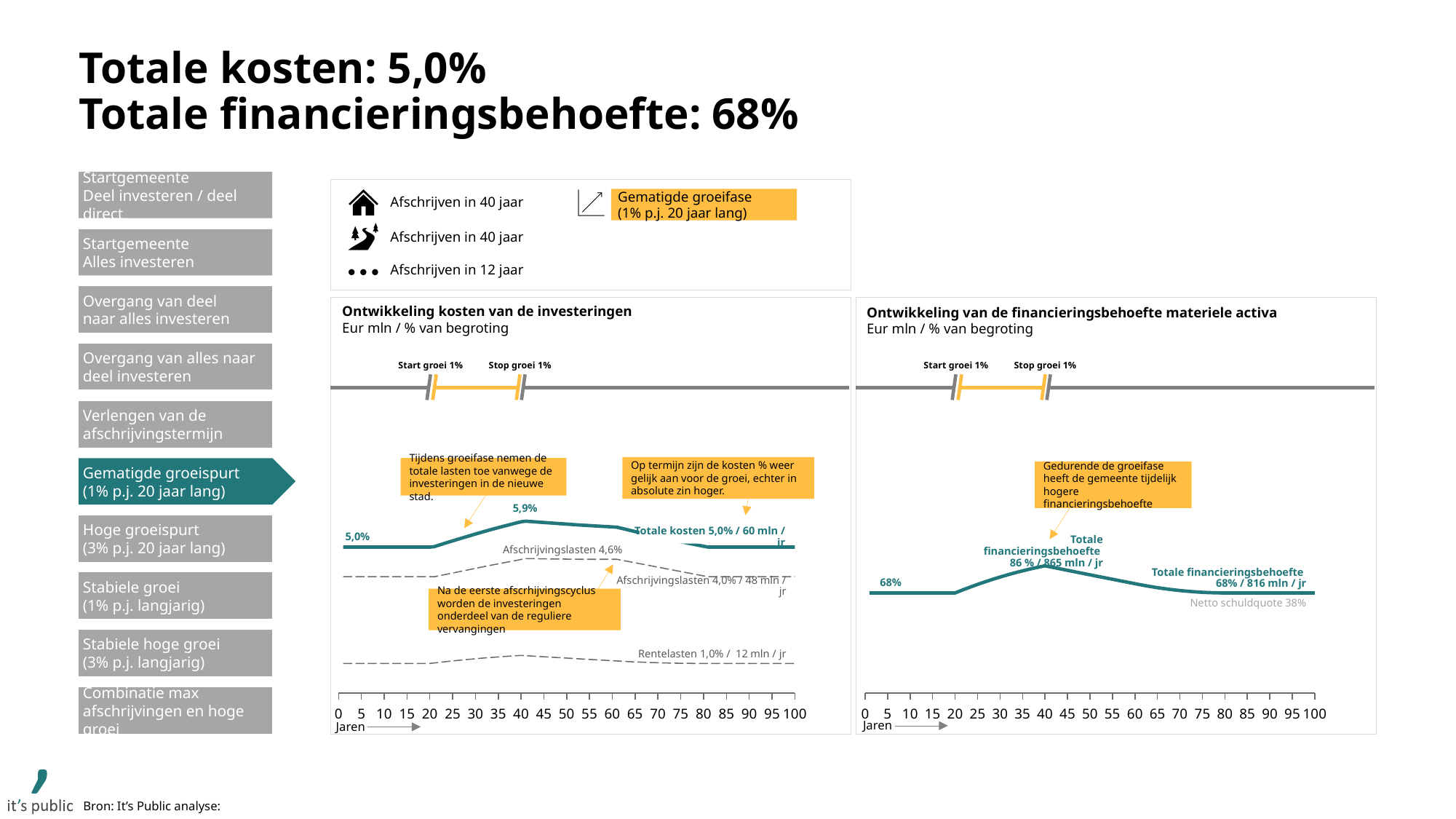
In the chart 'Ontwikkeling kosten van de investeringen', what is the peak value labelled for Afschrijvingslasten? 4,6% In the chart 'Ontwikkeling van de financieringsbehoefte materiele activa', what is the starting value of the Totale financieringsbehoefte line? 68% In the chart 'Ontwikkeling van de financieringsbehoefte materiele activa', what is the difference in percentage points between the peak financieringsbehoefte (86%) and the end value (68%)? 18 In the chart 'Ontwikkeling kosten van de investeringen', which is larger at the end of the period: Afschrijvingslasten or Rentelasten? Afschrijvingslasten What is the last value shown on the x axis (Jaren) of the chart 'Ontwikkeling van de financieringsbehoefte materiele activa'? 100 In the chart 'Ontwikkeling kosten van de investeringen', what is the starting value of the Totale kosten line? 5,0% What kind of chart is 'Ontwikkeling kosten van de investeringen'? Line chart In the chart 'Ontwikkeling kosten van de investeringen', what is the difference between the peak Totale kosten (5,9%) and the starting Totale kosten (5,0%)? 0,9% In the chart 'Ontwikkeling van de financieringsbehoefte materiele activa', what is the peak Totale financieringsbehoefte? 86 % / 865 mln / jr In the chart 'Ontwikkeling kosten van de investeringen', what is the peak value of the Totale kosten line? 5,9% In the chart 'Ontwikkeling van de financieringsbehoefte materiele activa', what is the Netto schuldquote shown? 38% In the chart 'Ontwikkeling kosten van de investeringen', what are the Rentelasten at the end of the period? 1,0% / 12 mln / jr